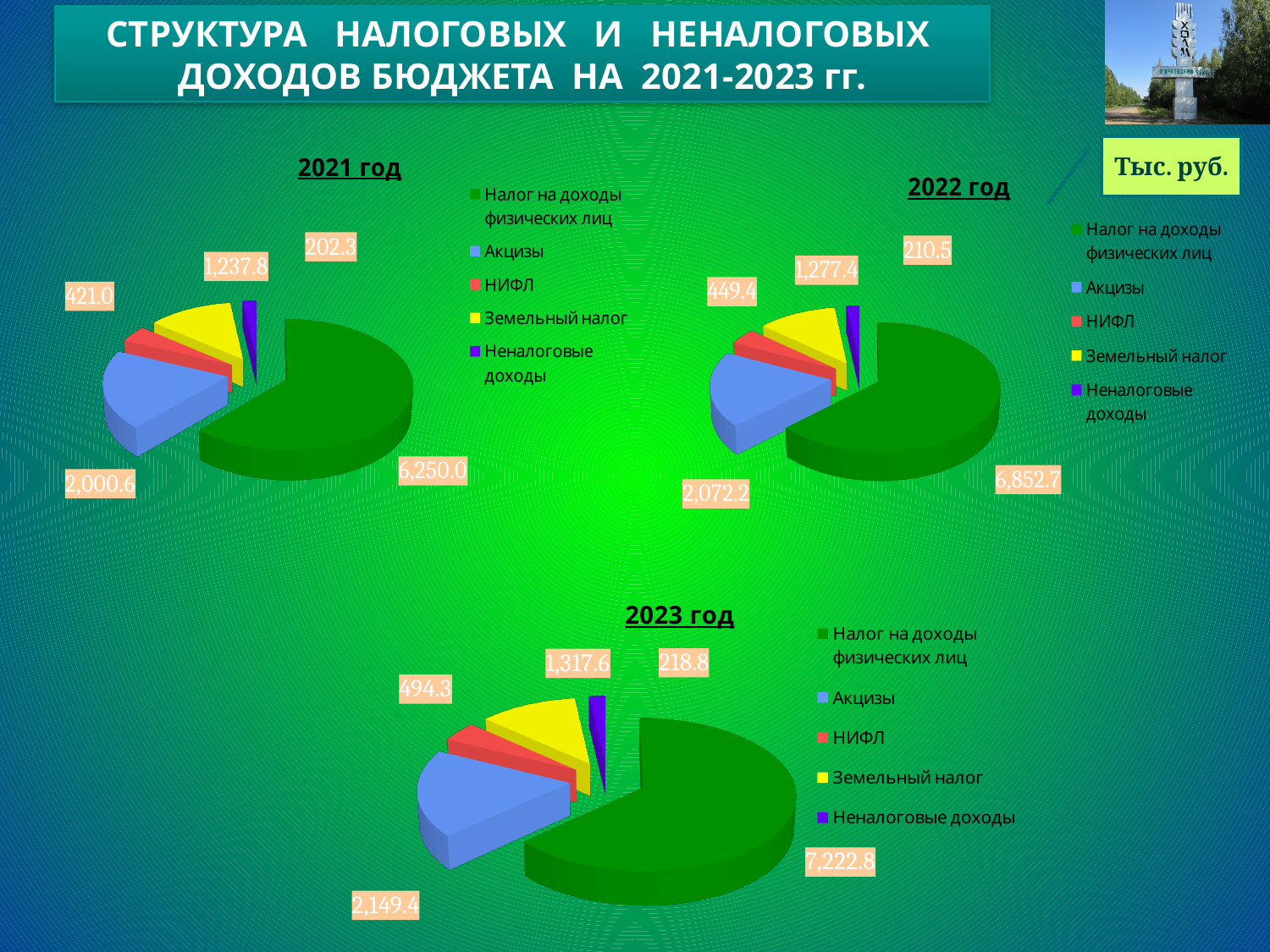
In the 2021 год chart, what is the value for Налог на доходы физических лиц? 6,250.0 How many entries does the legend of the 2021 год chart list? 5 In the 2022 год chart, what is the difference between Акцизы and Земельный налог? 794.8 In the 2022 год chart, what is the value for Акцизы? 2,072.2 In the 2023 год chart, which colour represents Акцизы? blue What type of chart is used for the 2021 год chart? pie chart How many slices does the 2023 год pie chart have? 5 In the 2022 год chart, which category has the largest value? Налог на доходы физических лиц In the 2023 год chart, which category has the smallest value? Неналоговые доходы In the 2023 год chart, what is the value for Земельный налог? 1,317.6 In the 2022 год chart, what is the value for НИФЛ? 449.4 In the 2021 год chart, which is larger: НИФЛ or Неналоговые доходы? НИФЛ